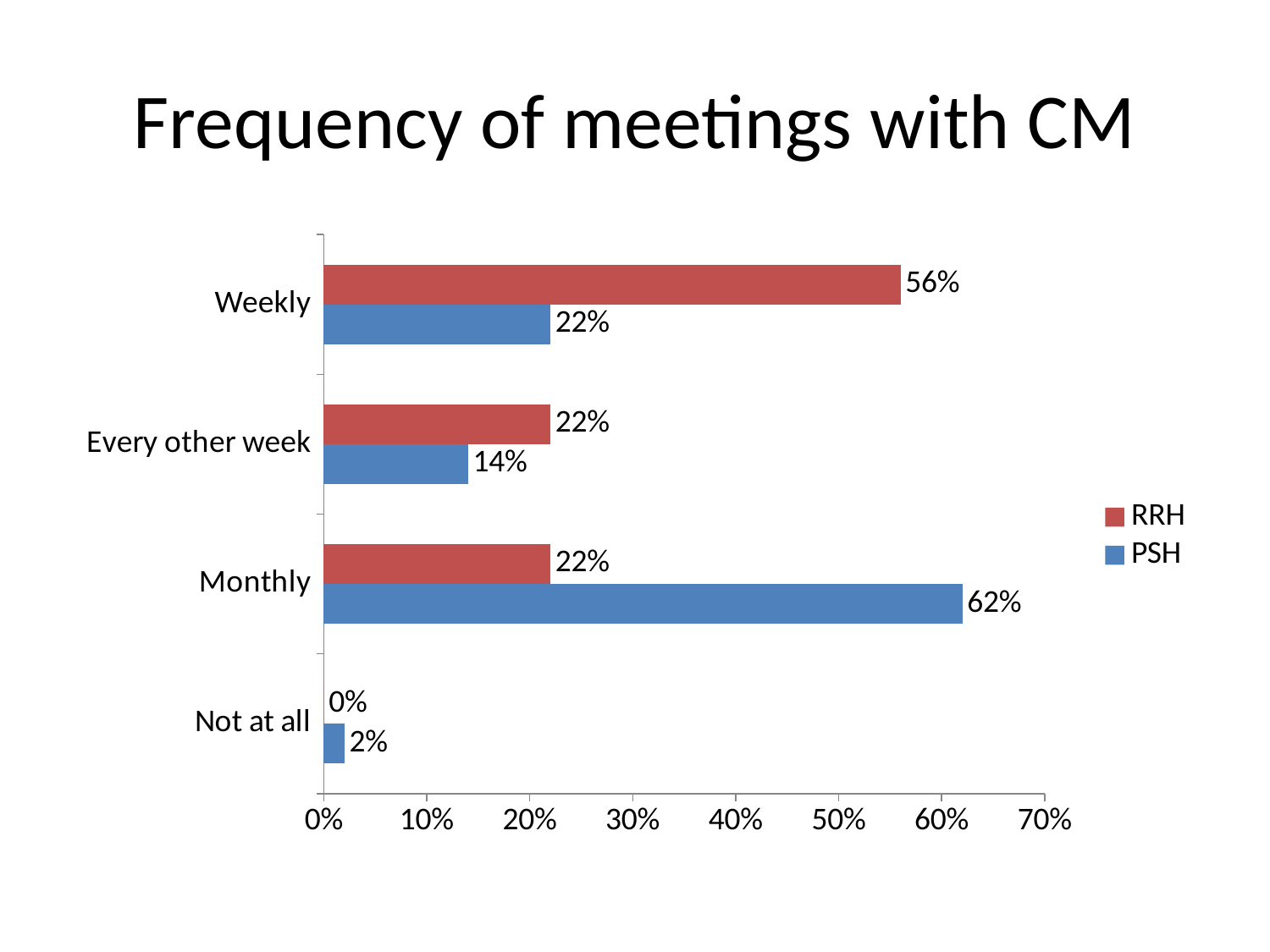
Which category has the highest PSH value? Monthly How many series does the legend list? 2 How many categories are shown on the chart? 4 Which category has the lowest RRH value? Not at all What is the PSH value for Monthly? 62% Which is larger for Monthly, the RRH value or the PSH value? PSH What is the title of the chart? Frequency of meetings with CM What is the PSH value for Every other week? 14% What is the RRH value for Weekly? 56% What kind of chart is shown on the slide? Bar chart What is the difference between the RRH and PSH values for Weekly? 34% What is the RRH value for Not at all? 0%